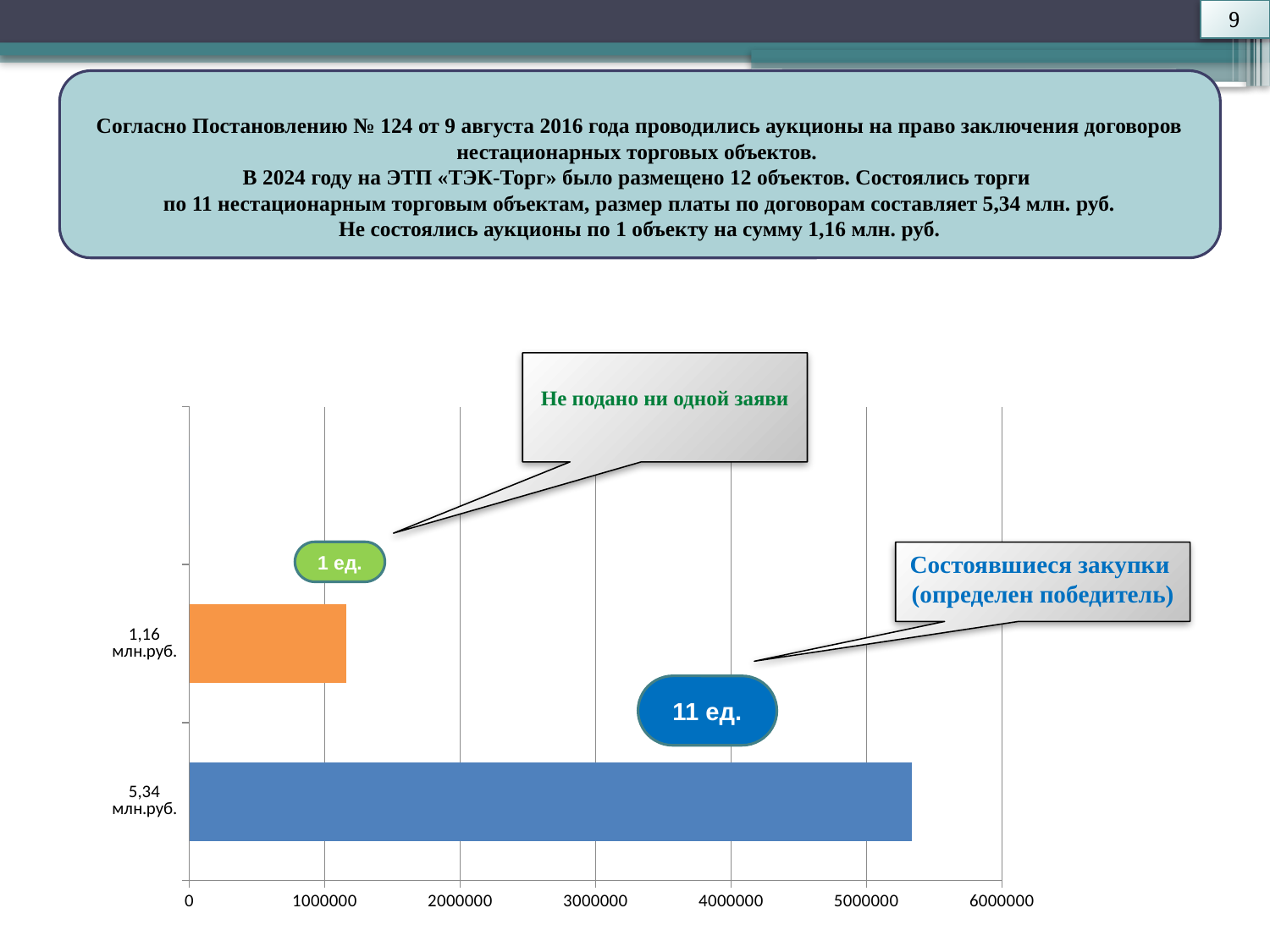
What value is labelled on the orange (upper) bar of the chart? 1,16 млн.руб. What value is labelled on the blue (lower) bar of the chart? 5,34 млн.руб. How many units (ед.) are indicated in the callout next to the blue bar? 11 ед. Which bar has the highest value? the blue bar (5,34 млн.руб.) Which bar has the lowest value? the orange bar (1,16 млн.руб.) Which bar is longer: the orange bar or the blue bar? the blue bar What is the maximum value shown on the x axis of the chart? 6000000 Is the value of the orange bar greater or less than 2000000 on the x axis? less What kind of chart is shown on the slide? bar chart What is the difference between the blue bar (5,34 млн.руб.) and the orange bar (1,16 млн.руб.)? 4,18 млн.руб. Is the value of the blue bar greater or less than 5000000 on the x axis? greater How many bars does the chart contain? 2